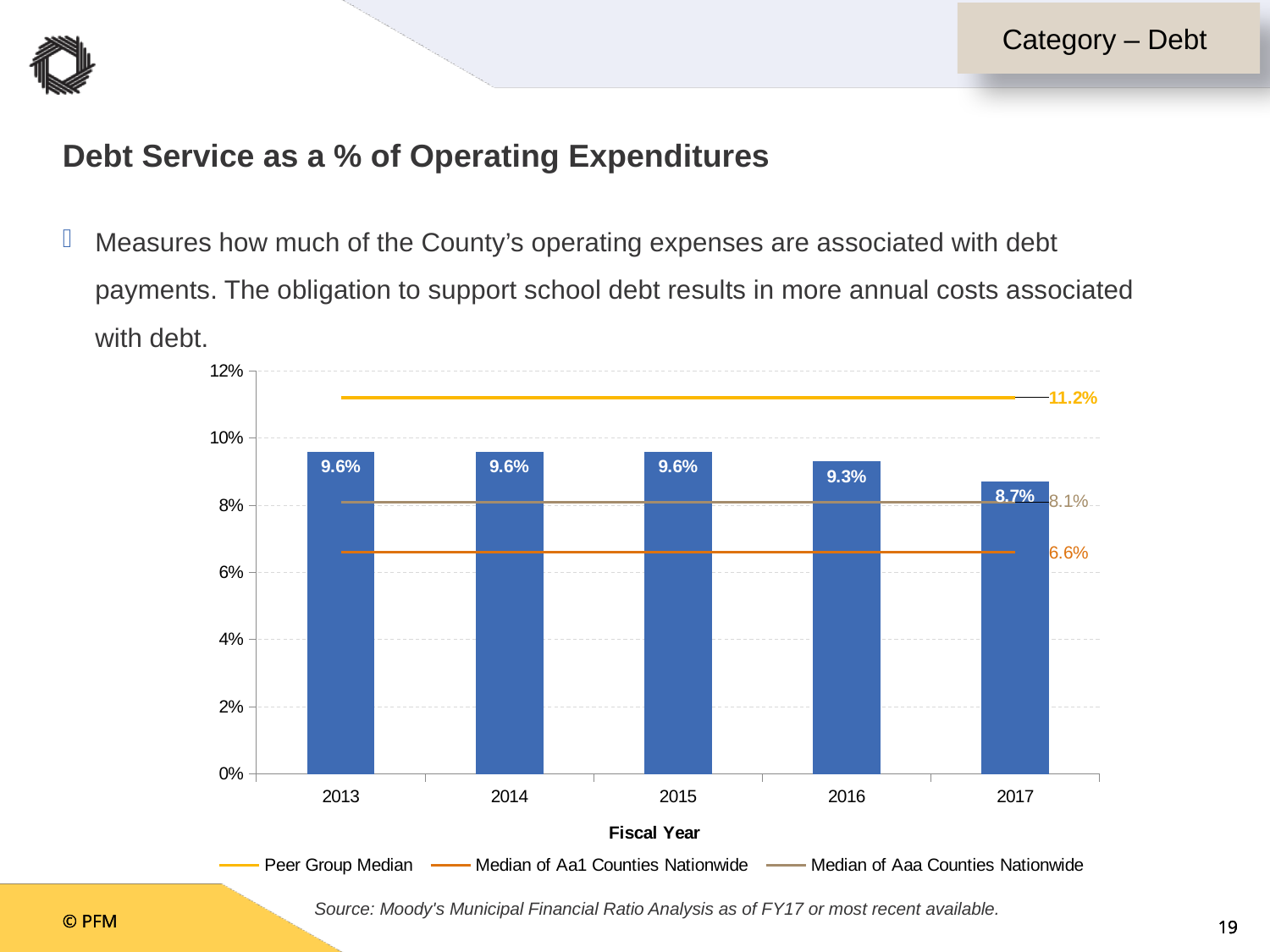
How many entries does the legend list? 3 What is the difference between the 2013 value and the 2017 value? 0.9% Do the bar values rise or fall from 2015 to 2017? fall What value is shown for the Peer Group Median line? 11.2% What is the debt service as a % of operating expenditures for fiscal year 2016? 9.3% Which fiscal year has the lowest debt service as a % of operating expenditures? 2017 What value is shown for the Median of Aa1 Counties Nationwide line? 6.6% How many fiscal years are shown on the x axis? 5 Is the 2017 value larger or smaller than the Median of Aaa Counties Nationwide (8.1%)? larger What is the debt service as a % of operating expenditures for fiscal year 2013? 9.6% What kind of chart is used to show the fiscal year values? bar chart What is the debt service as a % of operating expenditures for fiscal year 2017? 8.7%